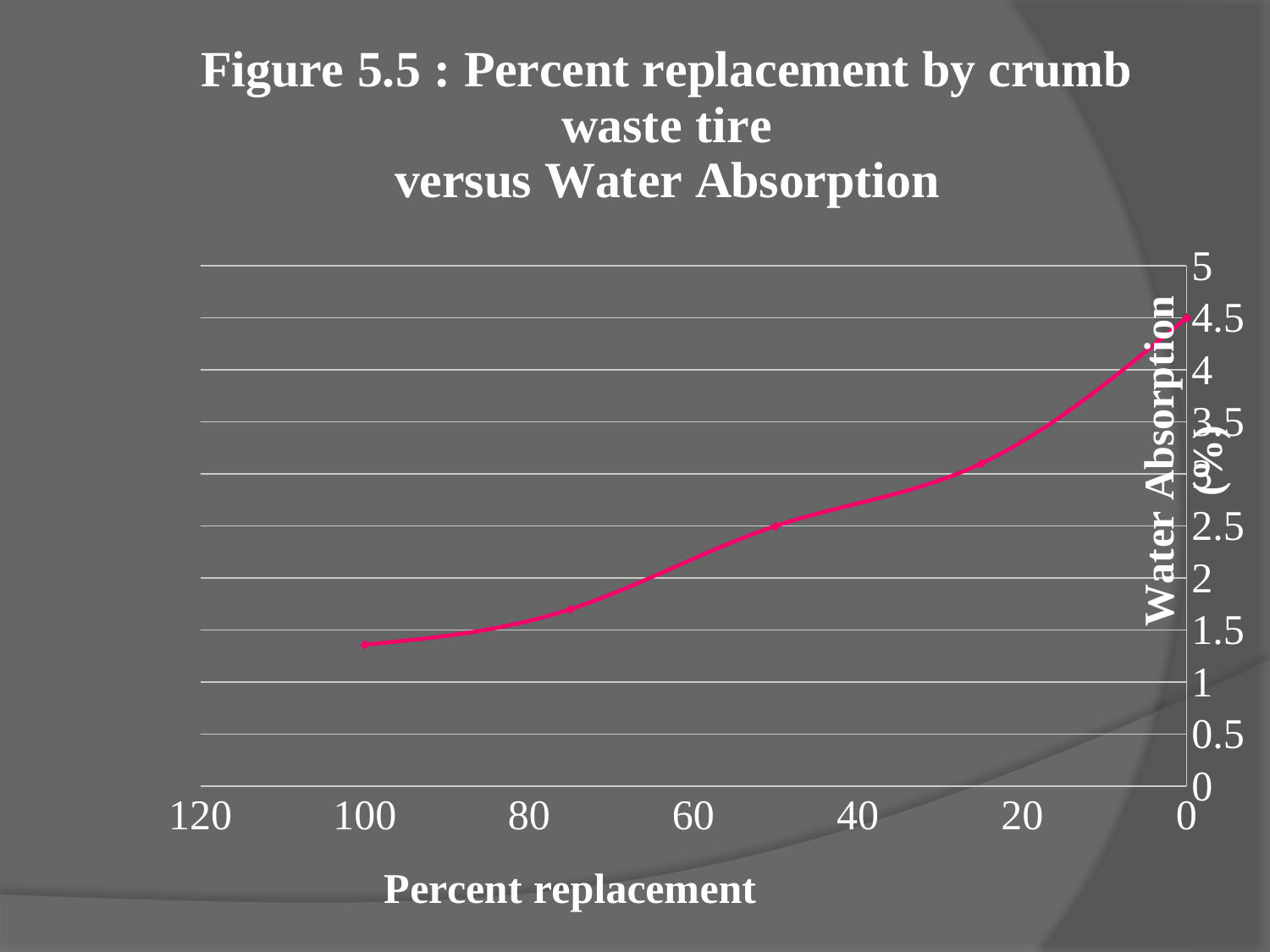
At which percent replacement is water absorption highest? 0 What is the water absorption at 50 percent replacement? 2.5 What is the difference in water absorption between 0 and 50 percent replacement? 2 Is the water absorption at 100 percent replacement greater or less than 1.5? less What is the title of the vertical axis? Water Absorption (%) Is the water absorption at 25 percent replacement greater or less than 3? greater At which percent replacement is water absorption lowest? 100 What is the water absorption at 0 percent replacement? 4.5 What kind of chart is shown on the slide? line chart How many data points are plotted on the line? 5 Does water absorption rise or fall as percent replacement increases? fall Which has higher water absorption: 25 percent replacement or 75 percent replacement? 25 percent replacement